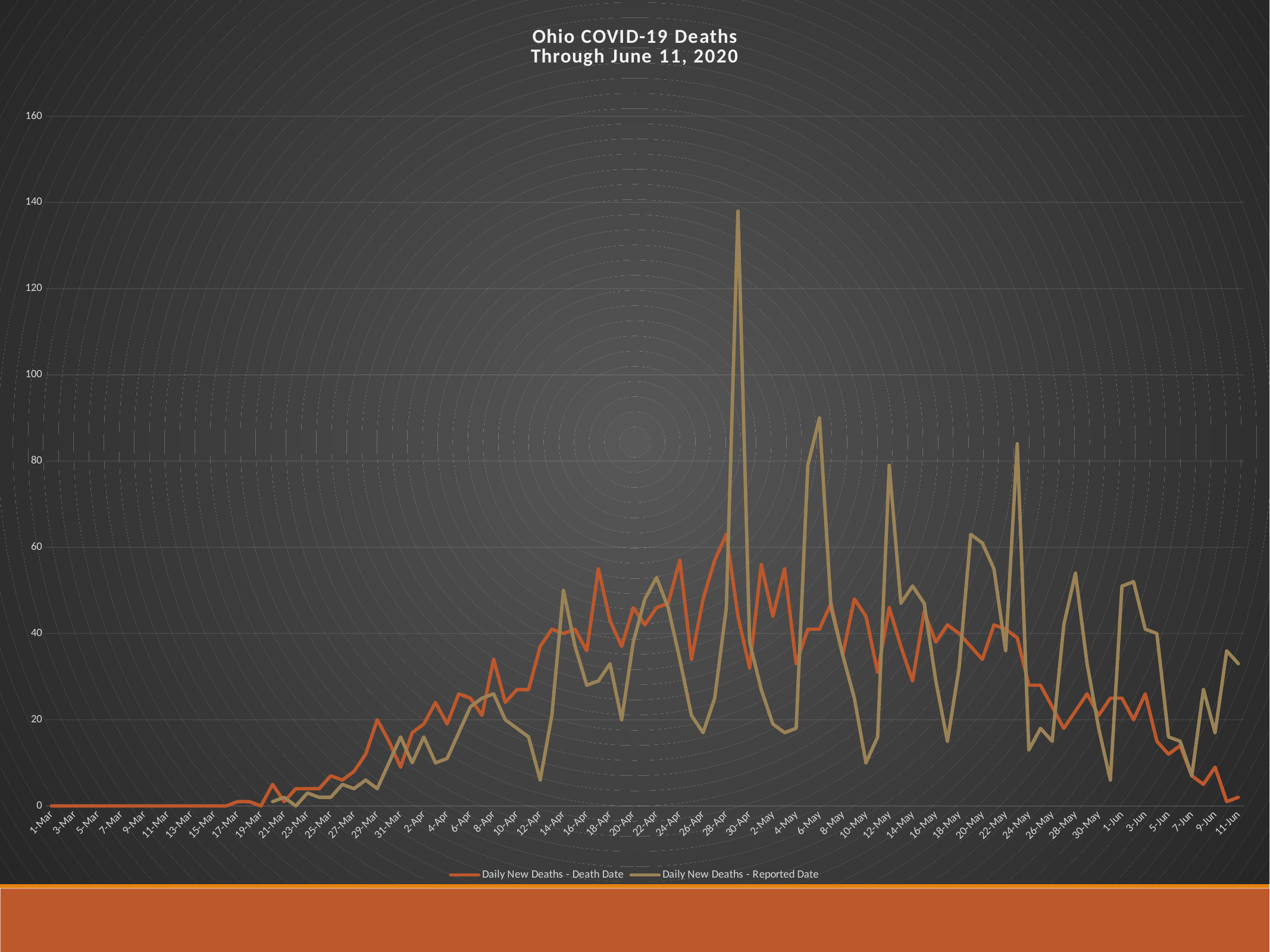
Does the Daily New Deaths - Death Date series generally rise or fall from 1-Mar to 28-Apr? rise On 10-May, which series has the larger value, Death Date or Reported Date? Daily New Deaths - Death Date On 6-May, which series has the larger value, Death Date or Reported Date? Daily New Deaths - Reported Date Is the value of the Daily New Deaths - Death Date series on 11-Jun greater or less than 20? less What is the value of the Daily New Deaths - Death Date series on 1-Mar? 0 Which series is drawn in the orange-red line? Daily New Deaths - Death Date Is the value of the Daily New Deaths - Reported Date series on 6-May greater or less than 80? greater How many series does the legend list? 2 Is the value of the Daily New Deaths - Reported Date series on 10-May greater or less than 20? less What is the title of the chart? Ohio COVID-19 Deaths Through June 11, 2020 What kind of chart is shown on the slide? Line chart